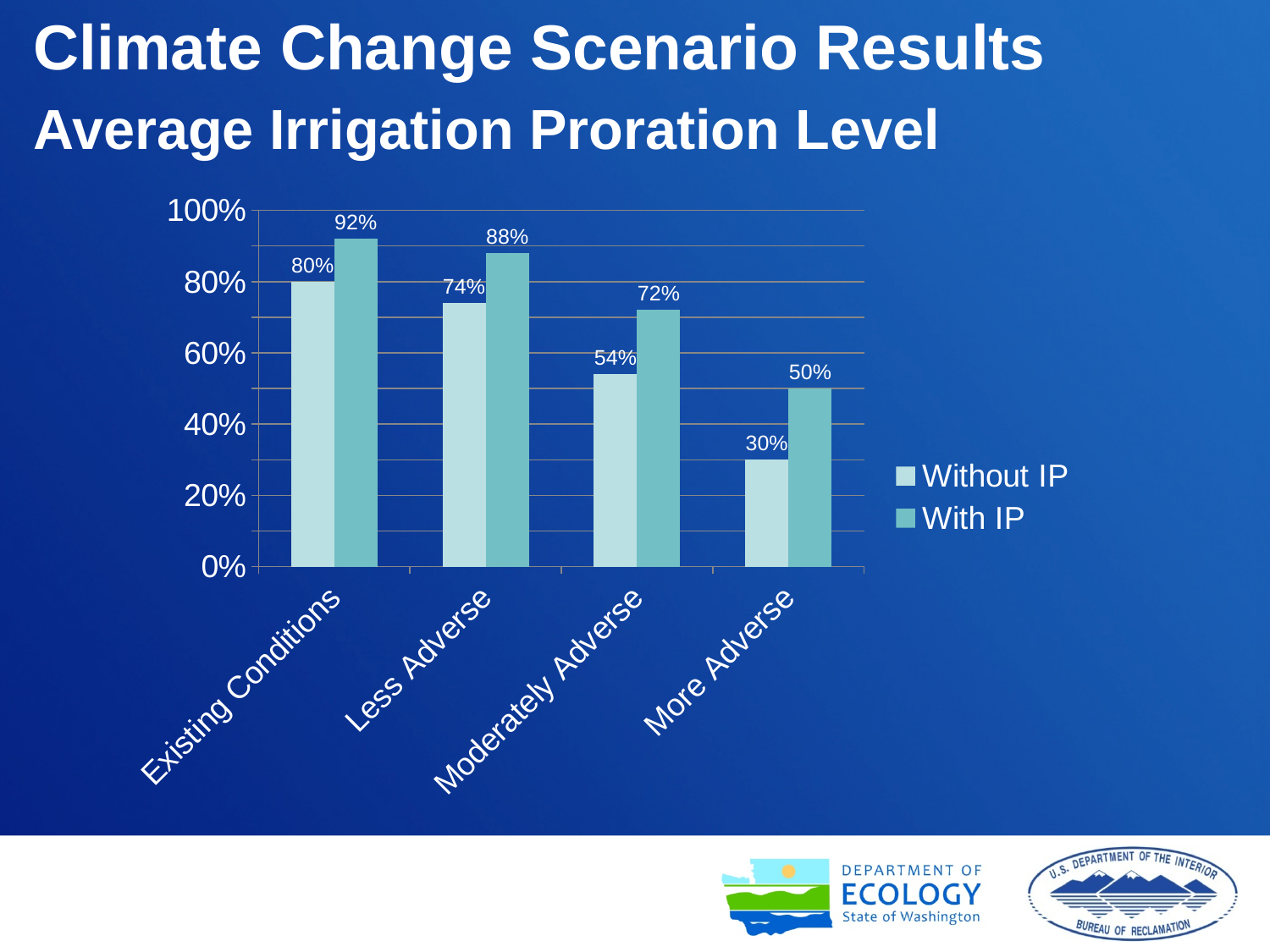
What is the difference between the Without IP values for Existing Conditions and More Adverse? 50% Do the Without IP values rise or fall from Existing Conditions to More Adverse? Fall How many series does the legend list? 2 Which category has the highest With IP value? Existing Conditions How many categories are shown on the x axis? 4 What is the With IP value for More Adverse? 50% What is the difference between the With IP and Without IP values for Moderately Adverse? 18% Which is larger for Less Adverse: the Without IP value or the With IP value? With IP What kind of chart is shown on the slide? Bar chart What is the Without IP value for Existing Conditions? 80% Which category has the lowest Without IP value? More Adverse What is the With IP value for Moderately Adverse? 72%